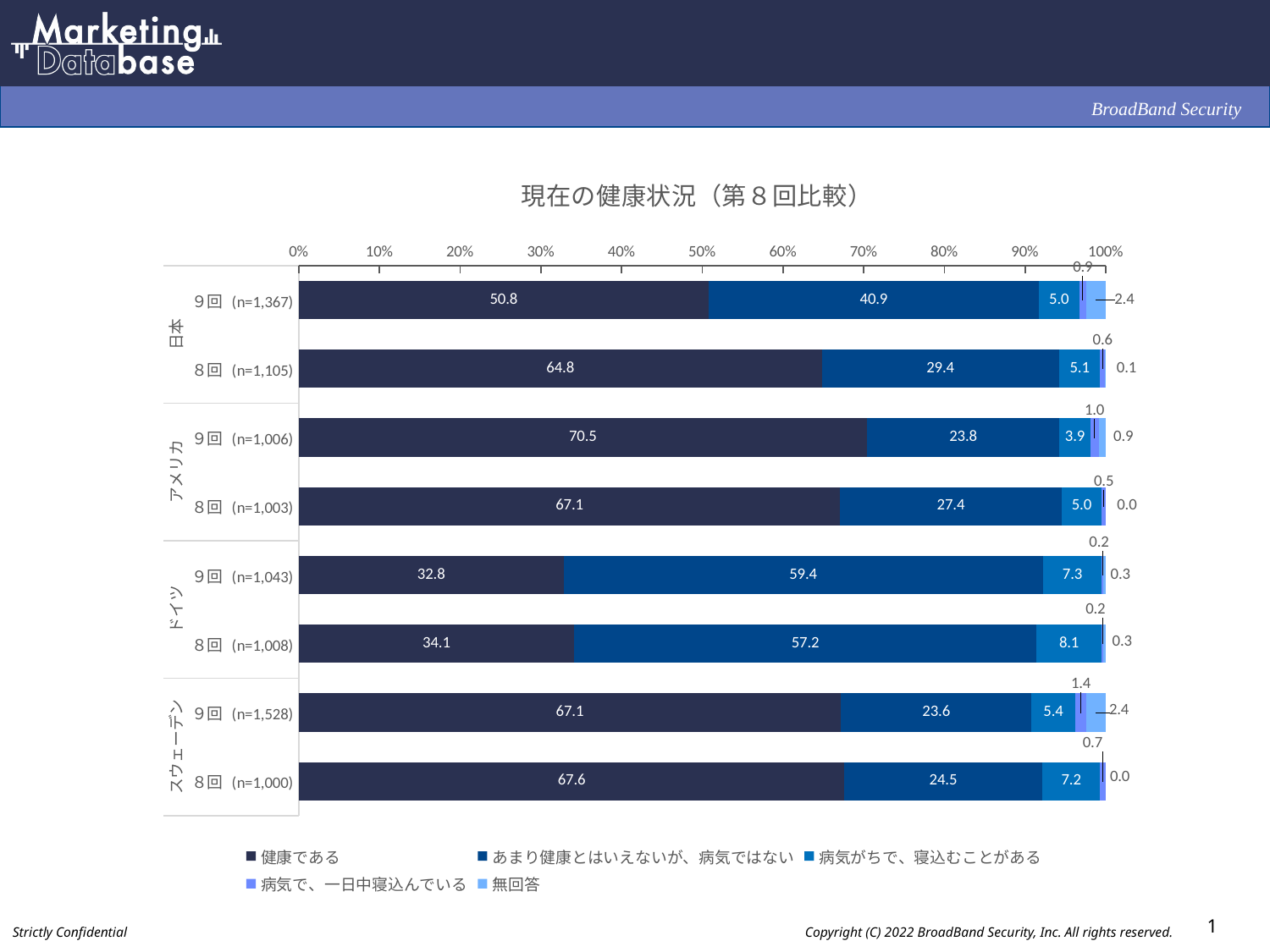
What is the value of 無回答 for 日本 9回 (n=1,367)? 2.4 What is the value of 健康である for 日本 9回 (n=1,367)? 50.8 What is the value of 病気がちで、寝込むことがある for スウェーデン 8回 (n=1,000)? 7.2 How many bars (category rows) are plotted in the chart? 8 Which category row has the lowest value for 健康である? ドイツ 9回 (n=1,043) What is the title of the chart? 現在の健康状況（第８回比較） What type of chart is shown on the slide? Stacked bar chart How many series does the legend list? 5 Which category row has the highest value for 健康である? アメリカ 9回 (n=1,006) Which is larger: the 病気がちで、寝込むことがある value for ドイツ 8回 (n=1,008) or for アメリカ 8回 (n=1,003)? ドイツ 8回 (n=1,008) What is the difference in 健康である between 日本 8回 (n=1,105) and 日本 9回 (n=1,367)? 14.0 What is the value of あまり健康とはいえないが、病気ではない for ドイツ 9回 (n=1,043)? 59.4